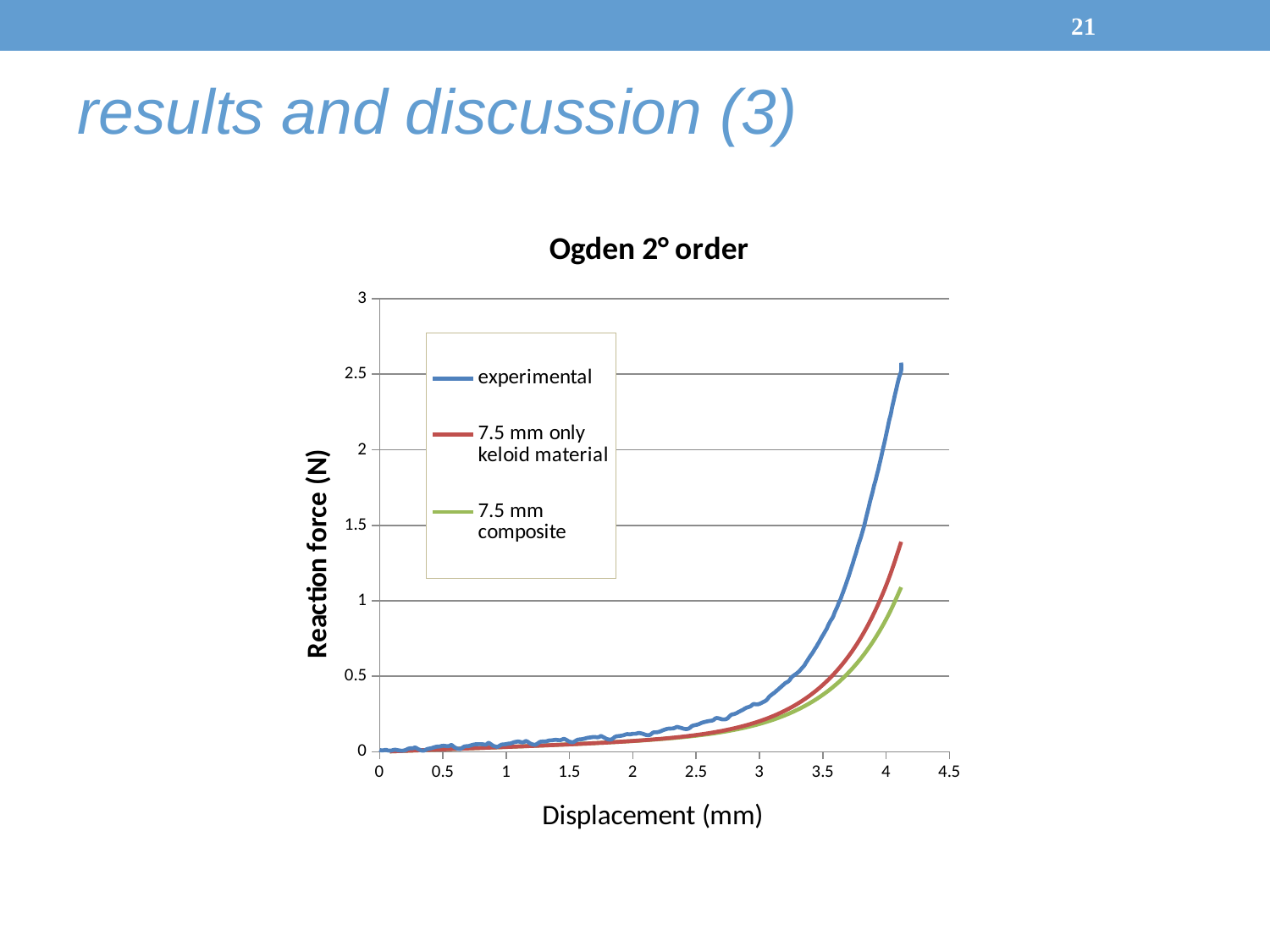
Do the values of the 7.5 mm composite series rise or fall along the x axis? rise Which series reaches the highest reaction force on the chart? experimental At the largest displacement shown, which series has the higher reaction force: experimental or 7.5 mm composite? experimental What is the title of the chart? Ogden 2° order What kind of chart is shown on the slide? line chart Do the values of the experimental series rise or fall as displacement increases? rise Is the highest value of the 7.5 mm composite series greater or less than 1.5? less Is the highest value of the experimental series greater or less than 2? greater What is the label of the y axis? Reaction force (N) At the largest displacement shown, which series has the higher reaction force: 7.5 mm only keloid material or 7.5 mm composite? 7.5 mm only keloid material Is the highest value of the 7.5 mm only keloid material series greater or less than 1? greater How many series does the legend list? 3